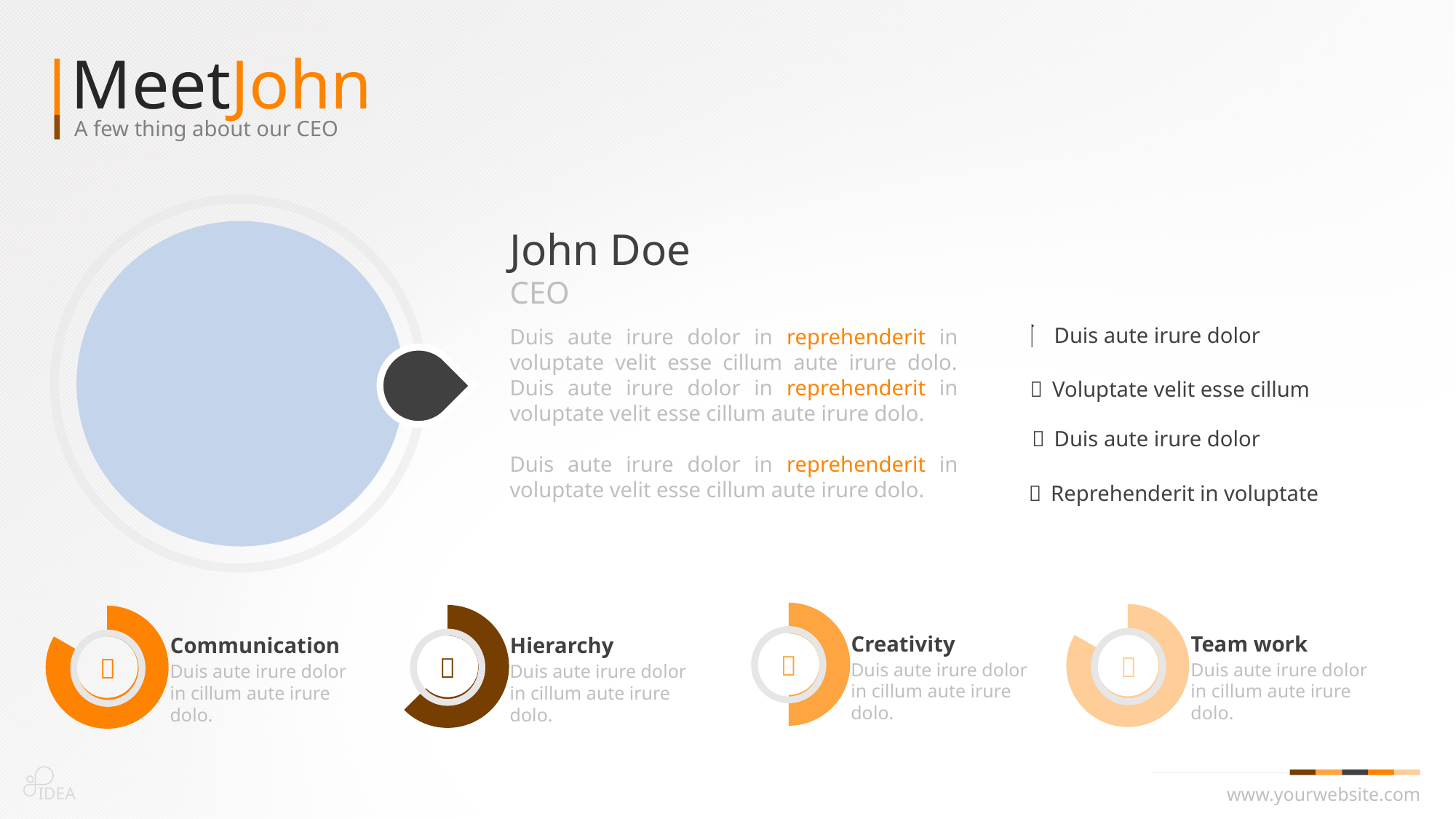
How many ring charts are shown along the bottom of the slide? 4 What kind of chart is used for the Communication, Hierarchy, Creativity and Team work indicators at the bottom of the slide? Doughnut (ring) chart What is the label of the second ring chart from the left at the bottom of the slide? Hierarchy Which of the bottom ring charts is filled more, Communication or Creativity? Communication Which of the bottom ring charts is filled more, Team work or Creativity? Team work What colour is the filled arc of the Hierarchy ring chart? Dark brown